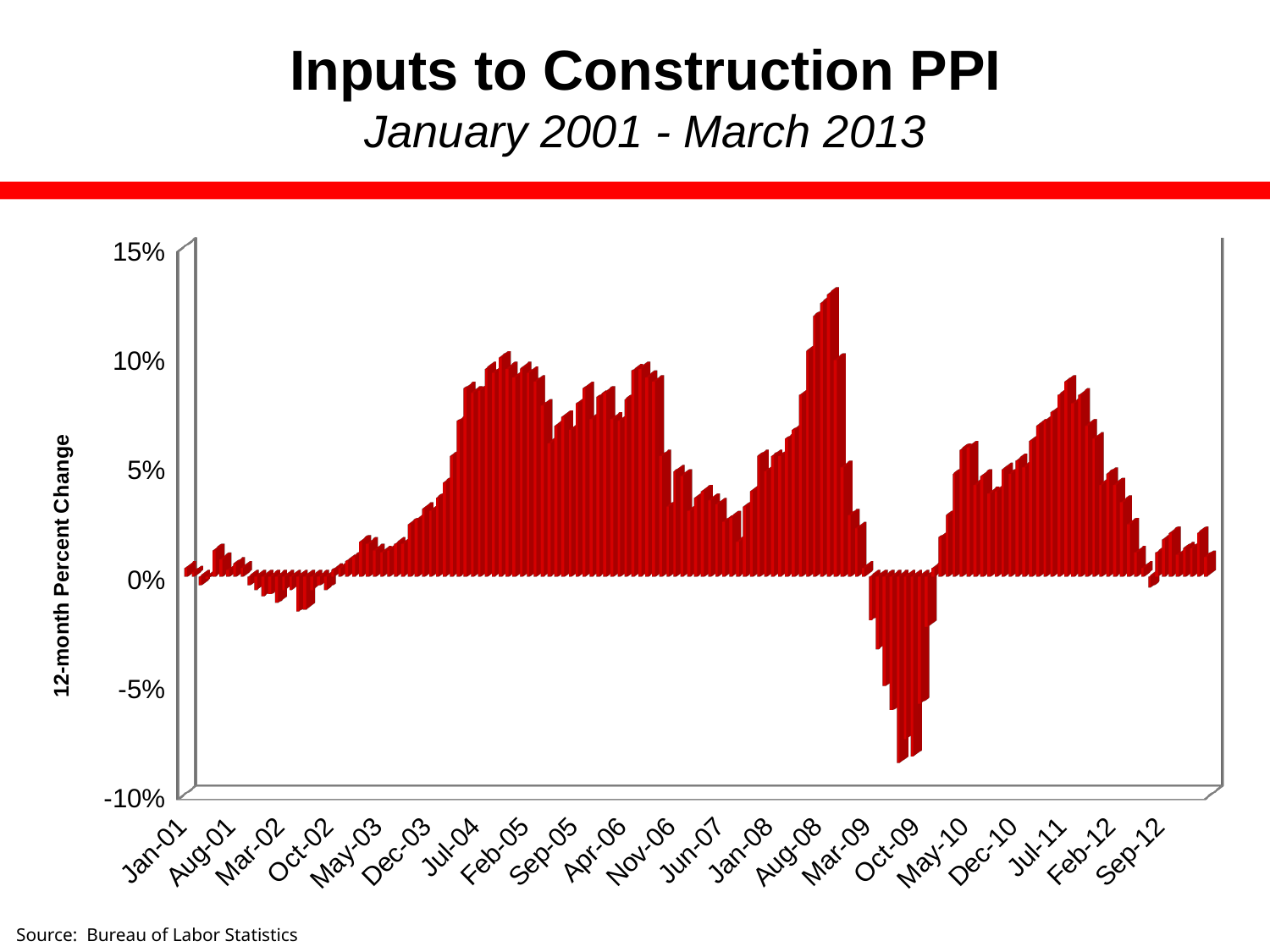
Is the value around Aug-08 greater or less than 10%? greater Around which x-axis label does the chart reach its highest value? Aug-08 What is the label on the vertical axis? 12-month Percent Change Is the value around Jul-04 greater or less than 5%? greater How many labels are shown on the x axis? 21 Is the value around Sep-12 greater or less than 5%? less Around which x-axis label does the chart reach its lowest value? Oct-09 Do the values rise or fall between Mar-09 and Oct-09? fall What is the title of the chart? Inputs to Construction PPI Which is larger, the value around Jul-04 or the value around Jan-01? Jul-04 What kind of chart is shown on the slide? bar chart